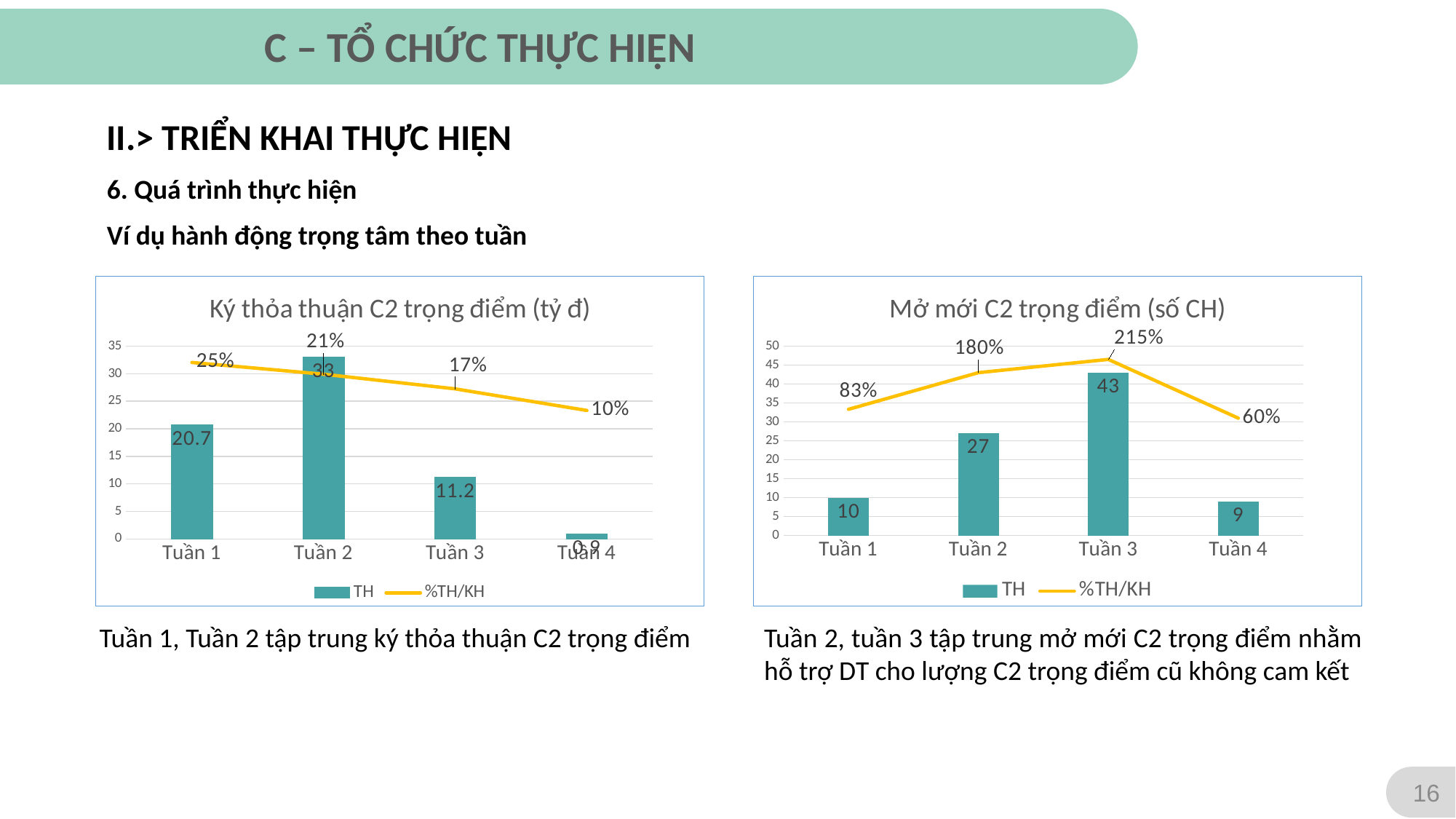
In the chart titled 'Mở mới C2 trọng điểm (số CH)', which week has the lowest TH value? Tuần 4 In the chart titled 'Ký thỏa thuận C2 trọng điểm (tỷ đ)', what is the difference between the TH values for Tuần 1 and Tuần 3? 9.5 In the chart titled 'Mở mới C2 trọng điểm (số CH)', what is the %TH/KH value for Tuần 2? 180% How many series does the legend list in the chart titled 'Mở mới C2 trọng điểm (số CH)'? 2 In the chart titled 'Mở mới C2 trọng điểm (số CH)', what is the TH value for Tuần 3? 43 In the chart titled 'Mở mới C2 trọng điểm (số CH)', what is the difference between the TH values for Tuần 3 and Tuần 2? 16 In the chart titled 'Ký thỏa thuận C2 trọng điểm (tỷ đ)', which week has the highest TH value? Tuần 2 In the chart titled 'Mở mới C2 trọng điểm (số CH)', which is larger, the TH value for Tuần 1 or Tuần 4? Tuần 1 In the chart titled 'Ký thỏa thuận C2 trọng điểm (tỷ đ)', does the %TH/KH line rise or fall from Tuần 1 to Tuần 4? Fall In the chart titled 'Ký thỏa thuận C2 trọng điểm (tỷ đ)', is the TH value for Tuần 4 greater or less than 5? less In the chart titled 'Ký thỏa thuận C2 trọng điểm (tỷ đ)', what is the TH value for Tuần 2? 33 In the chart titled 'Ký thỏa thuận C2 trọng điểm (tỷ đ)', what is the %TH/KH value for Tuần 3? 17%